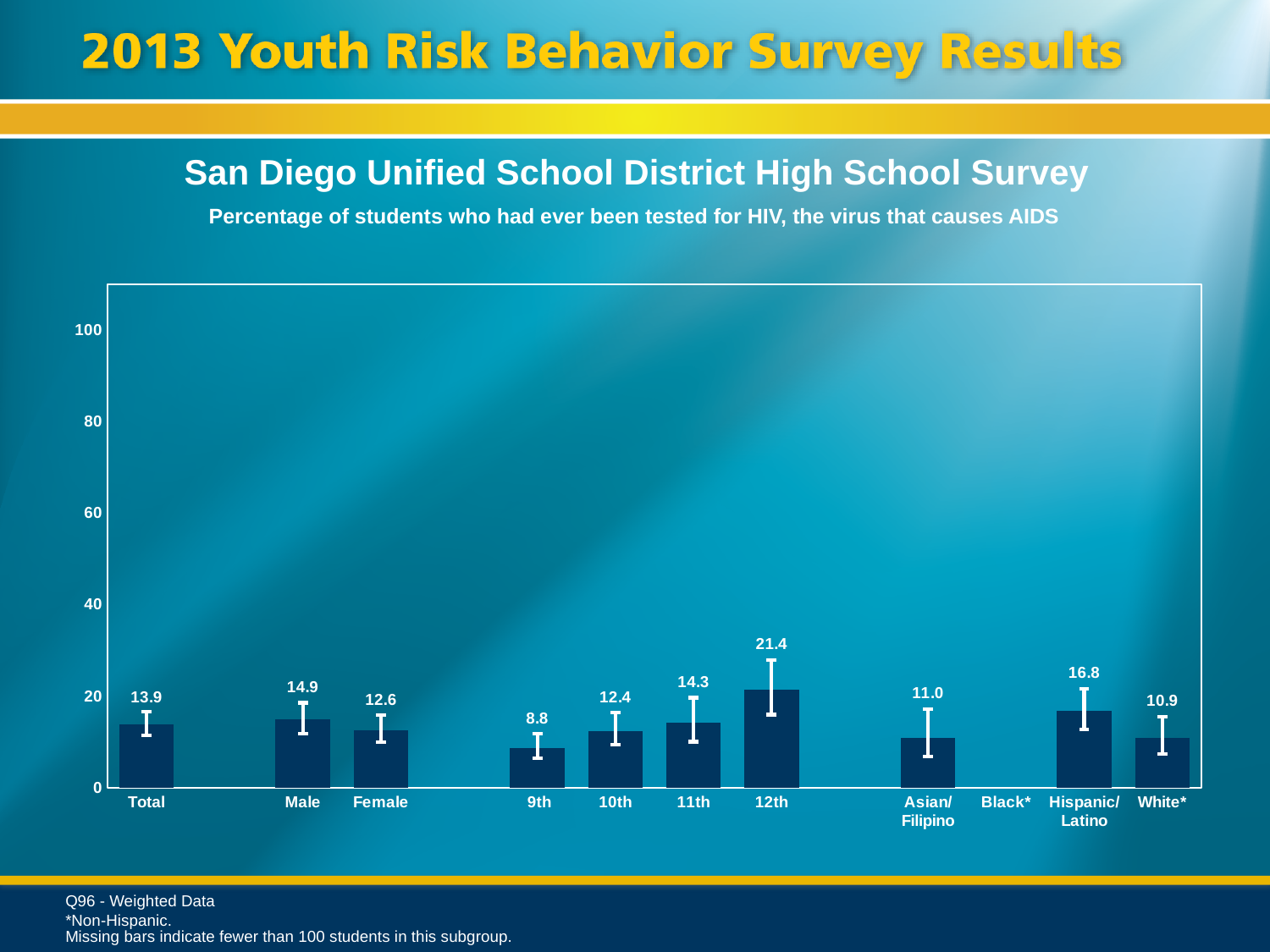
What is the value for 12th grade? 21.4 What is the value for Hispanic/Latino students? 16.8 What is the value for Total? 13.9 How many categories have a bar plotted? 11 What is the difference between the Male and Female values? 2.3 Which category with a bar has the lowest value? 9th What is the value for 9th grade? 8.8 What kind of chart is shown? bar chart Which is larger, the value for 11th grade or the value for 10th grade? 11th Which category has the highest value? 12th Which category label has no bar plotted? Black* Is the value for 12th grade greater or less than 20? greater